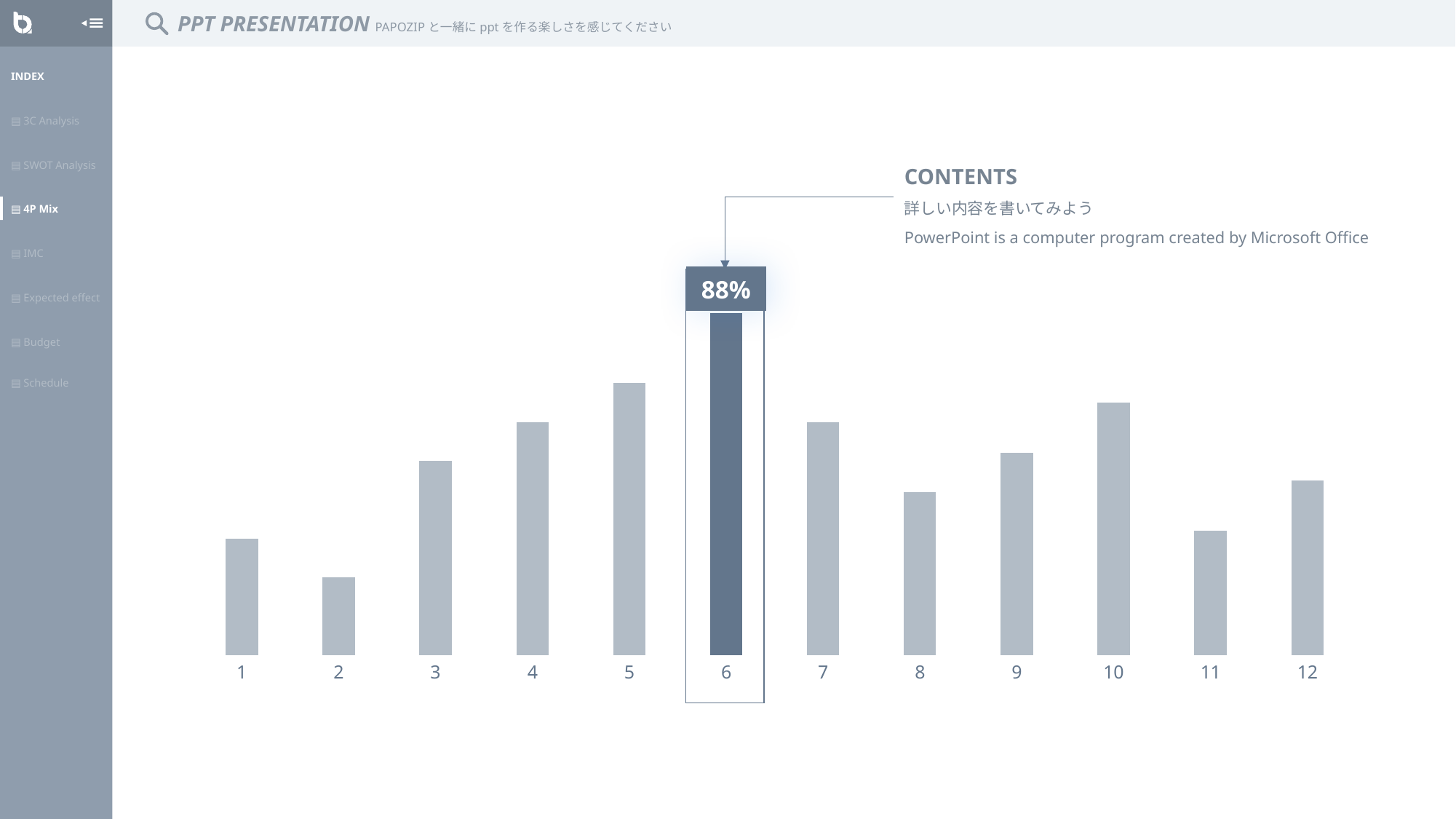
Which category has the lowest bar in the chart? 2 What kind of chart is shown on the slide? bar chart Which bar is taller, category 5 or category 4? 5 How many categories are plotted on the x axis of the chart? 12 Which category's bar is highlighted in a darker colour than the others? 6 Which bar is taller, category 10 or category 7? 10 Which bar is taller, category 12 or category 11? 12 What is the heading of the text box that the arrow from bar 6 points to? CONTENTS Which category has the highest bar in the chart? 6 What value is labelled on the bar for category 6? 88%